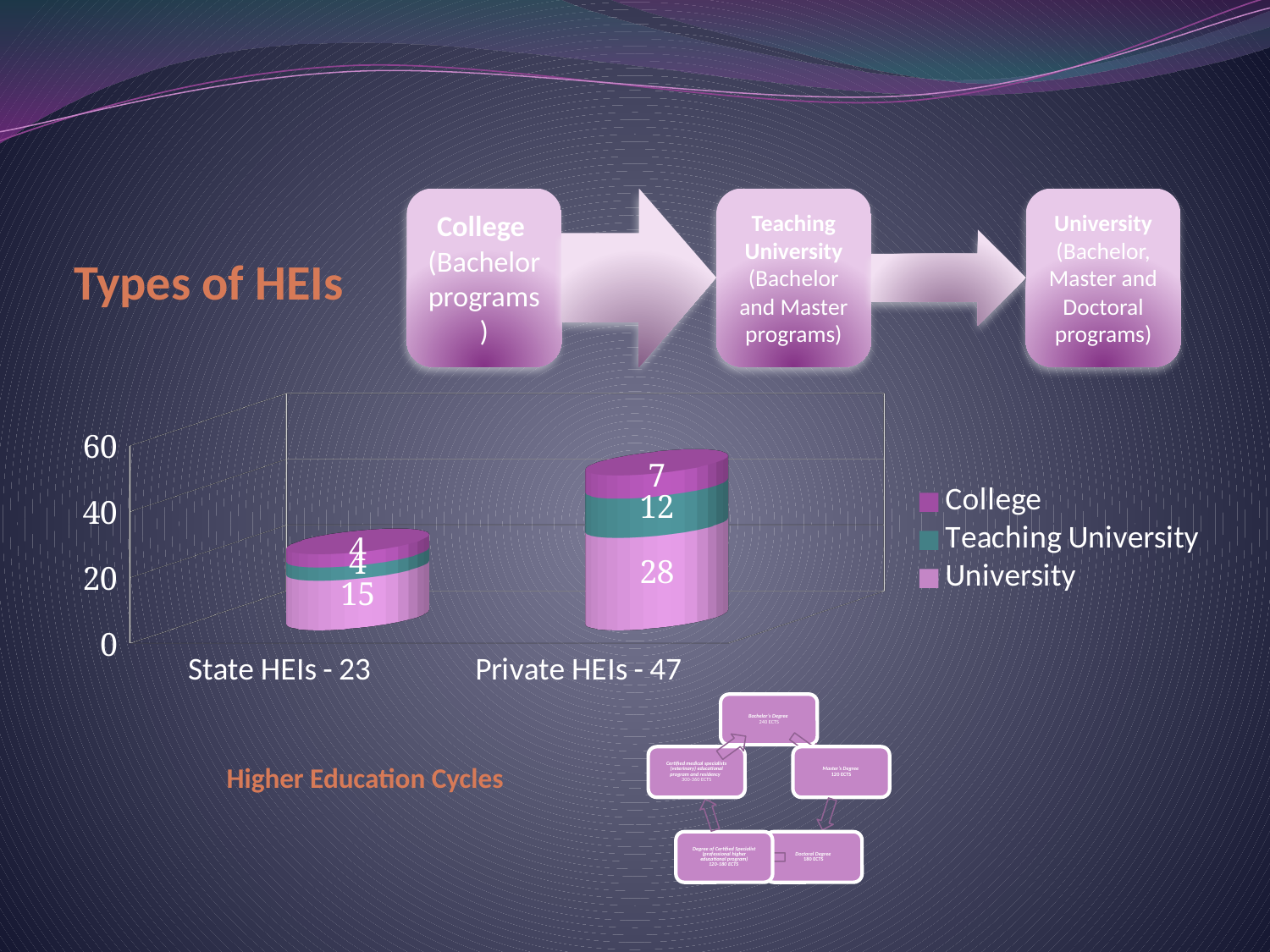
What is the value for University in the Private HEIs - 47 bar? 28 What kind of chart is shown on the slide? Stacked bar chart What is the total of the stacked bar for State HEIs - 23? 23 What is the difference between the University values for Private HEIs and State HEIs? 13 How many categories are shown on the x axis of the chart? 2 Which category has the larger Teaching University value, State HEIs or Private HEIs? Private HEIs What is the value for University in the State HEIs - 23 bar? 15 How many series does the chart legend list? 3 What is the value for Teaching University in the Private HEIs - 47 bar? 12 What is the total of the stacked bar for Private HEIs - 47? 47 What is the value for College in the Private HEIs - 47 bar? 7 Which category has the taller stacked bar? Private HEIs - 47